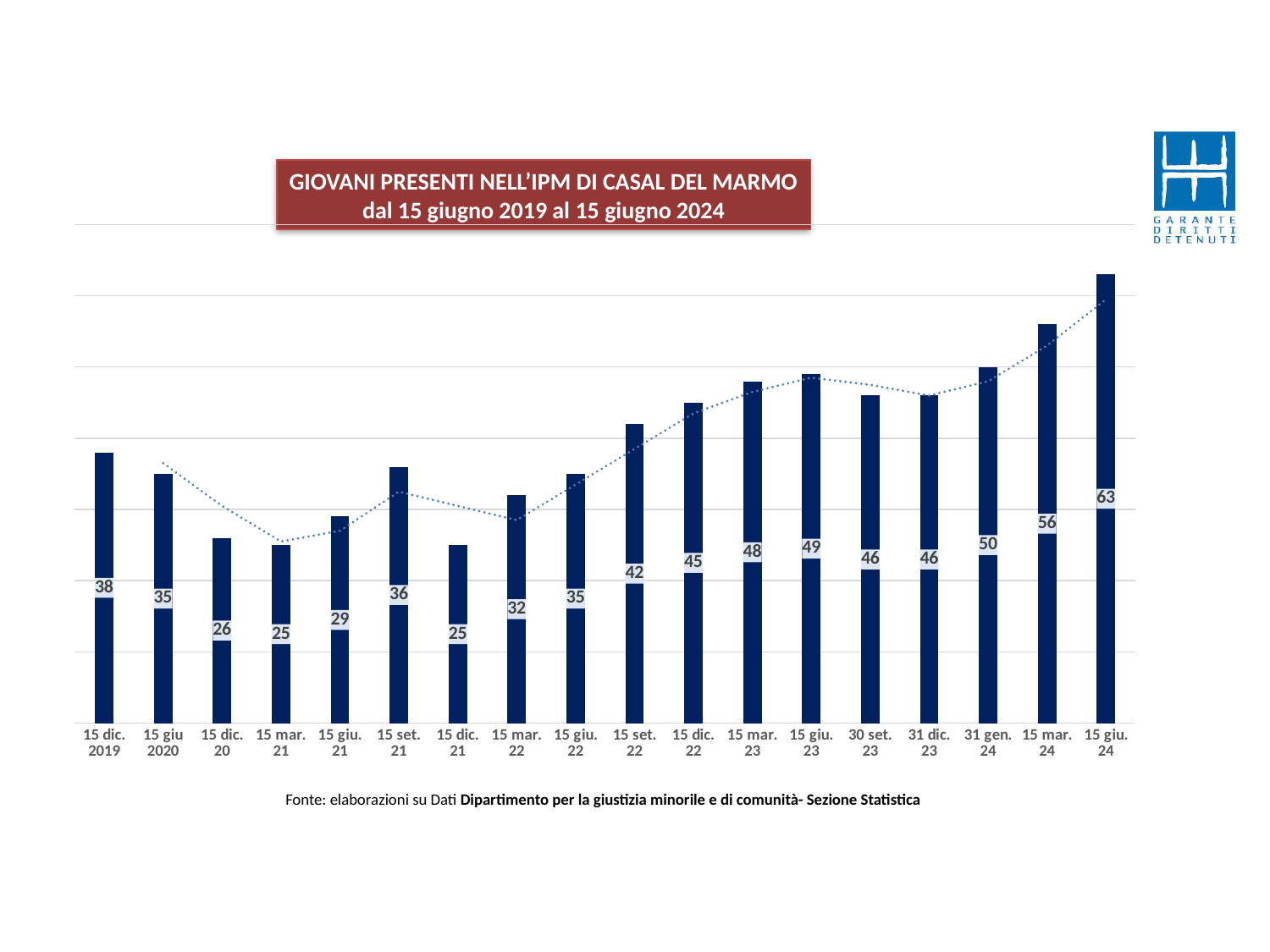
Which is larger, the value for 15 giu. 23 or the value for 30 set. 23? 15 giu. 23 What kind of chart is this? Bar chart What is the lowest value shown on the chart? 25 What is the difference between the values for 15 giu. 24 and 15 mar. 24? 7 What is the value for 15 giu. 24? 63 Which date has the highest value? 15 giu. 24 How many bars are shown on the chart? 18 What is the value for 15 set. 22? 42 What is the value for 31 gen. 24? 50 What is the difference between the values for 15 dic. 2019 and 15 dic. 20? 12 What is the value for 15 dic. 2019? 38 Do the values generally rise or fall from 15 dic. 21 to 15 giu. 24? Rise